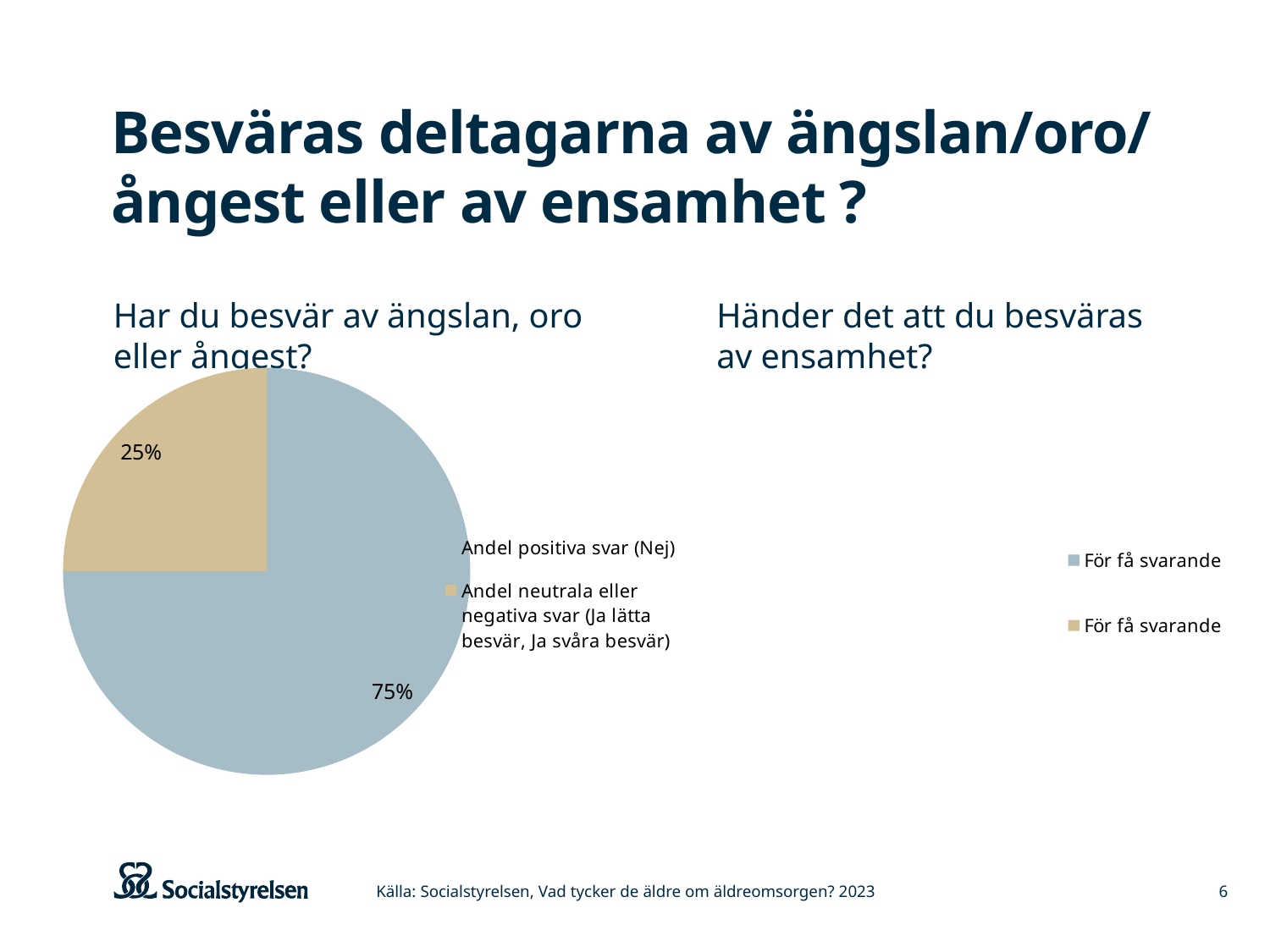
What kind of chart is the one titled "Har du besvär av ängslan, oro eller ångest?"? Pie chart In the chart titled "Har du besvär av ängslan, oro eller ångest?", what is the difference in percentage points between the positive answers and the neutral or negative answers? 50 percentage points In the chart titled "Har du besvär av ängslan, oro eller ångest?", which category has the largest slice? Andel positiva svar (Nej) In the chart titled "Har du besvär av ängslan, oro eller ångest?", which colour is used for the "Andel positiva svar (Nej)" slice? Blue-grey How many slices does the pie chart titled "Har du besvär av ängslan, oro eller ångest?" have? 2 In the chart titled "Har du besvär av ängslan, oro eller ångest?", what share of responses is "Andel positiva svar (Nej)"? 75% In the chart titled "Har du besvär av ängslan, oro eller ångest?", what share of the pie does the beige slice represent? 25% In the chart titled "Har du besvär av ängslan, oro eller ångest?", what share of responses is "Andel neutrala eller negativa svar (Ja lätta besvär, Ja svåra besvär)"? 25% How many entries does the legend of the chart titled "Har du besvär av ängslan, oro eller ångest?" list? 2 In the chart titled "Har du besvär av ängslan, oro eller ångest?", which category has the smallest slice? Andel neutrala eller negativa svar (Ja lätta besvär, Ja svåra besvär) In the chart titled "Har du besvär av ängslan, oro eller ångest?", which is larger: the share of positive answers (Nej) or the share of neutral or negative answers? Andel positiva svar (Nej) What do the legend entries of the chart titled "Händer det att du besväras av ensamhet?" say? För få svarande